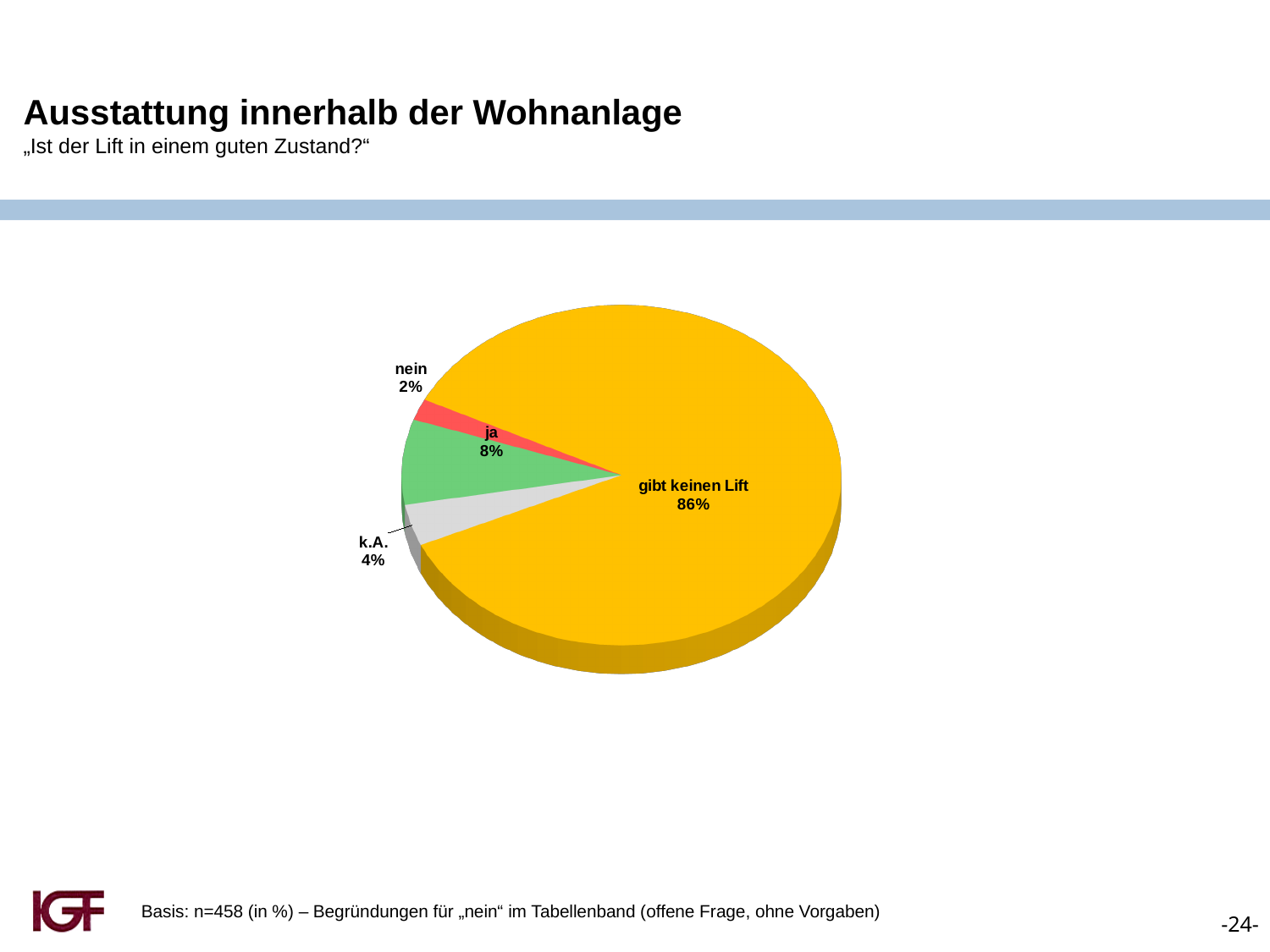
What share of respondents answered "ja"? 8% What share of respondents answered "nein"? 2% What is the combined share of "ja" and "nein"? 10% Which category has the smallest slice of the pie? nein How many slices does the pie chart have? 4 What share of respondents answered "gibt keinen Lift"? 86% What share of respondents answered "k.A."? 4% What is the difference in percentage points between "ja" and "nein"? 6 percentage points What kind of chart is shown on the slide? pie chart What colour is the "gibt keinen Lift" slice? yellow Which category has the largest slice of the pie? gibt keinen Lift Which is larger, the share for "k.A." or the share for "ja"? ja